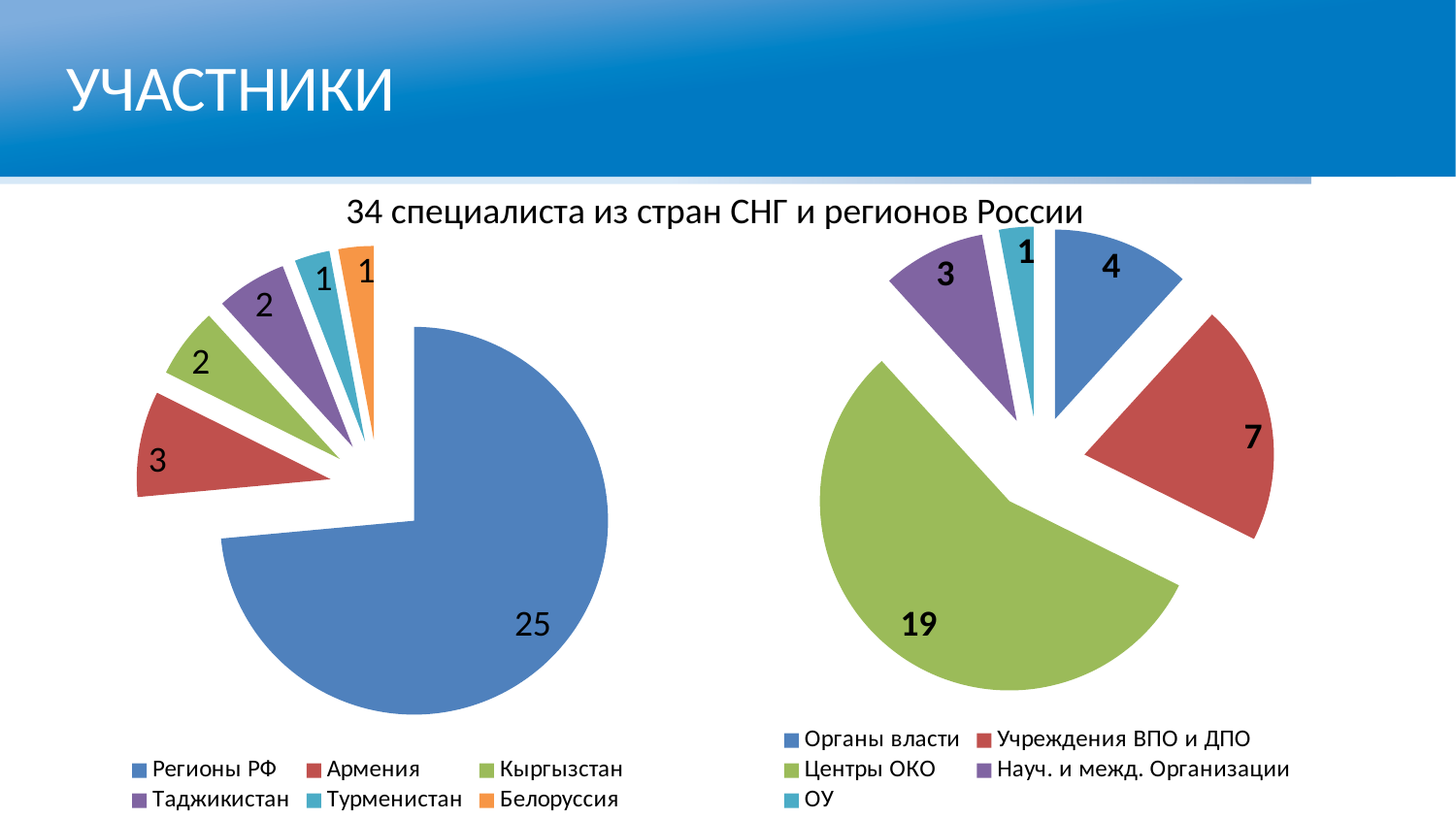
In the left pie chart, which category has the largest slice? Регионы РФ In the left pie chart, what is the value for Регионы РФ? 25 In the right pie chart, what is the value for Учреждения ВПО и ДПО? 7 What kind of chart is the left chart on the slide? pie chart In the right pie chart, what is the value for Центры ОКО? 19 What is the title shown above the left pie chart? 34 специалиста из стран СНГ и регионов России In the left pie chart, what is the difference between the values for Регионы РФ and Армения? 22 In the right pie chart, what is the difference between the values for Центры ОКО and Органы власти? 15 In the left pie chart, how many categories does the legend list? 6 In the left pie chart, which is larger, the value for Армения or the value for Кыргызстан? Армения In the right pie chart, which category has the smallest slice? ОУ In the left pie chart, what is the value for Армения? 3